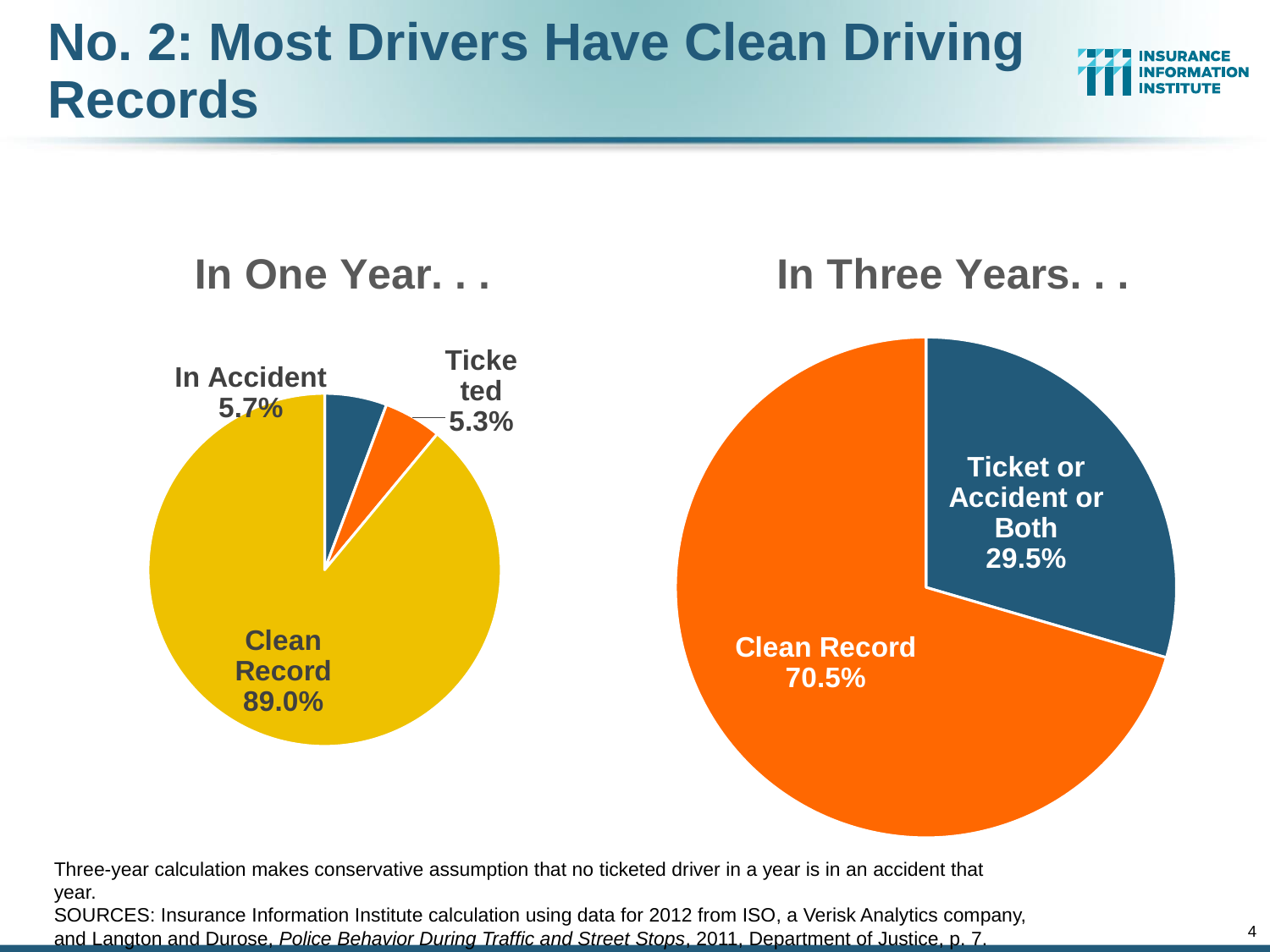
In the "In One Year. . ." chart, what share of drivers have a Clean Record? 89.0% Which is larger: the Clean Record share in the "In One Year. . ." chart or the Clean Record share in the "In Three Years. . ." chart? In One Year How many slices does the "In One Year. . ." chart have? 3 In the "In One Year. . ." chart, which category has the largest slice? Clean Record In the "In One Year. . ." chart, what share of drivers were Ticketed? 5.3% In the "In Three Years. . ." chart, what share of drivers had a Ticket or Accident or Both? 29.5% In the "In One Year. . ." chart, what share of drivers were In Accident? 5.7% How many slices does the "In Three Years. . ." chart have? 2 In the "In One Year. . ." chart, which category has the smallest slice? Ticketed In the "In Three Years. . ." chart, what is the difference between the Clean Record share and the Ticket or Accident or Both share? 41.0% In the "In Three Years. . ." chart, what share of drivers have a Clean Record? 70.5% What type of chart is the "In Three Years. . ." chart? Pie chart